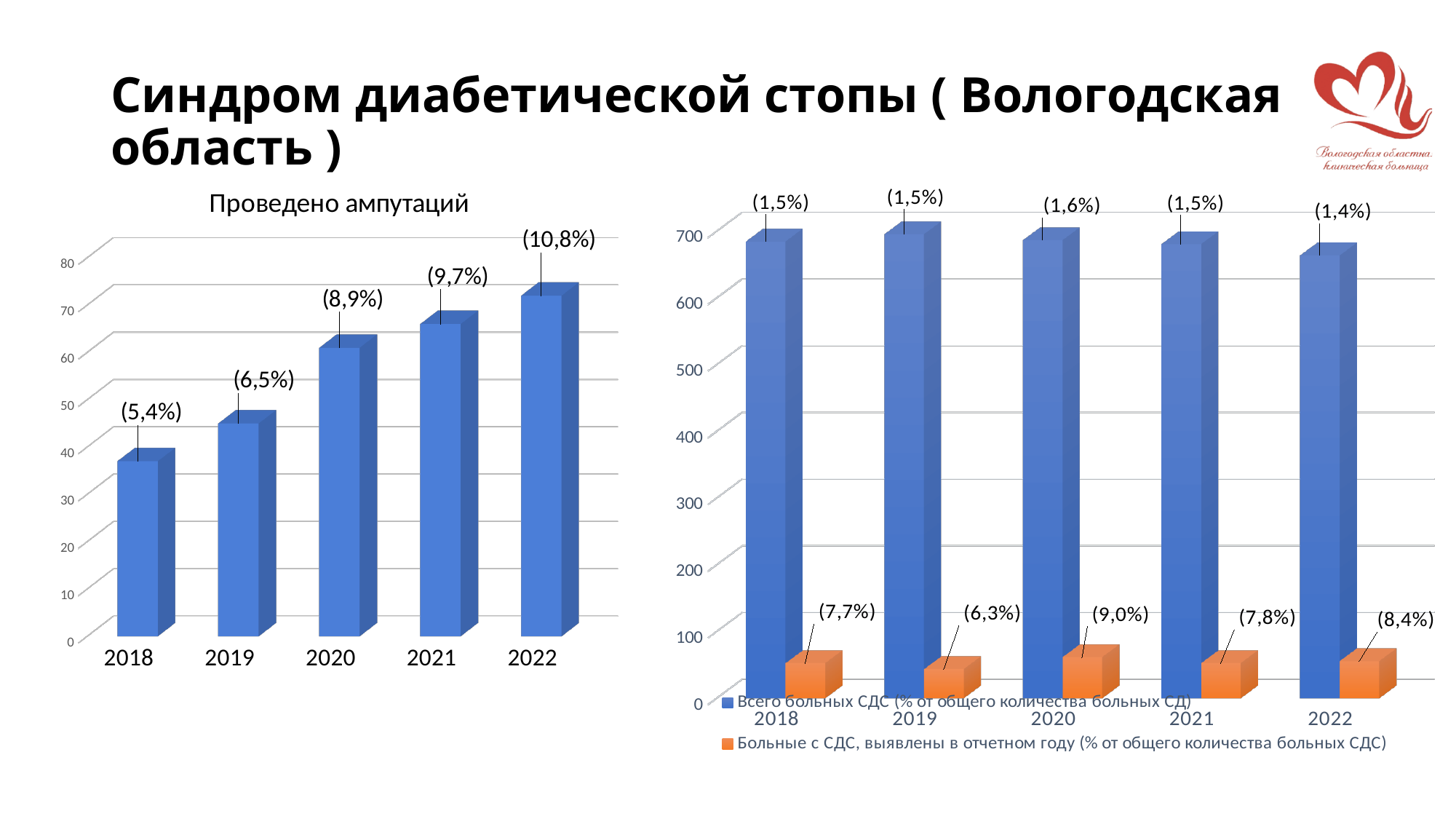
How many years are shown on the x axis of the left chart titled "Проведено ампутаций"? 5 In the right chart, what percentage label is shown above the blue bar for 2022? (1,4%) In the right chart, what percentage label is shown above the orange bar for 2020? (9,0%) In the left chart titled "Проведено ампутаций", is the value for 2018 greater or less than 40? less In the left chart titled "Проведено ампутаций", do the bar values rise or fall from 2018 to 2022? rise In the left chart titled "Проведено ампутаций", what percentage label is shown above the 2022 bar? (10,8%) In the right chart, which year has the lowest percentage label on the orange series? 2019 How many series does the legend of the right chart list? 2 In the right chart, is the blue bar for 2022 greater or less than 600? greater What kind of chart is the right chart? bar chart In the left chart titled "Проведено ампутаций", what percentage label is shown above the 2018 bar? (5,4%)